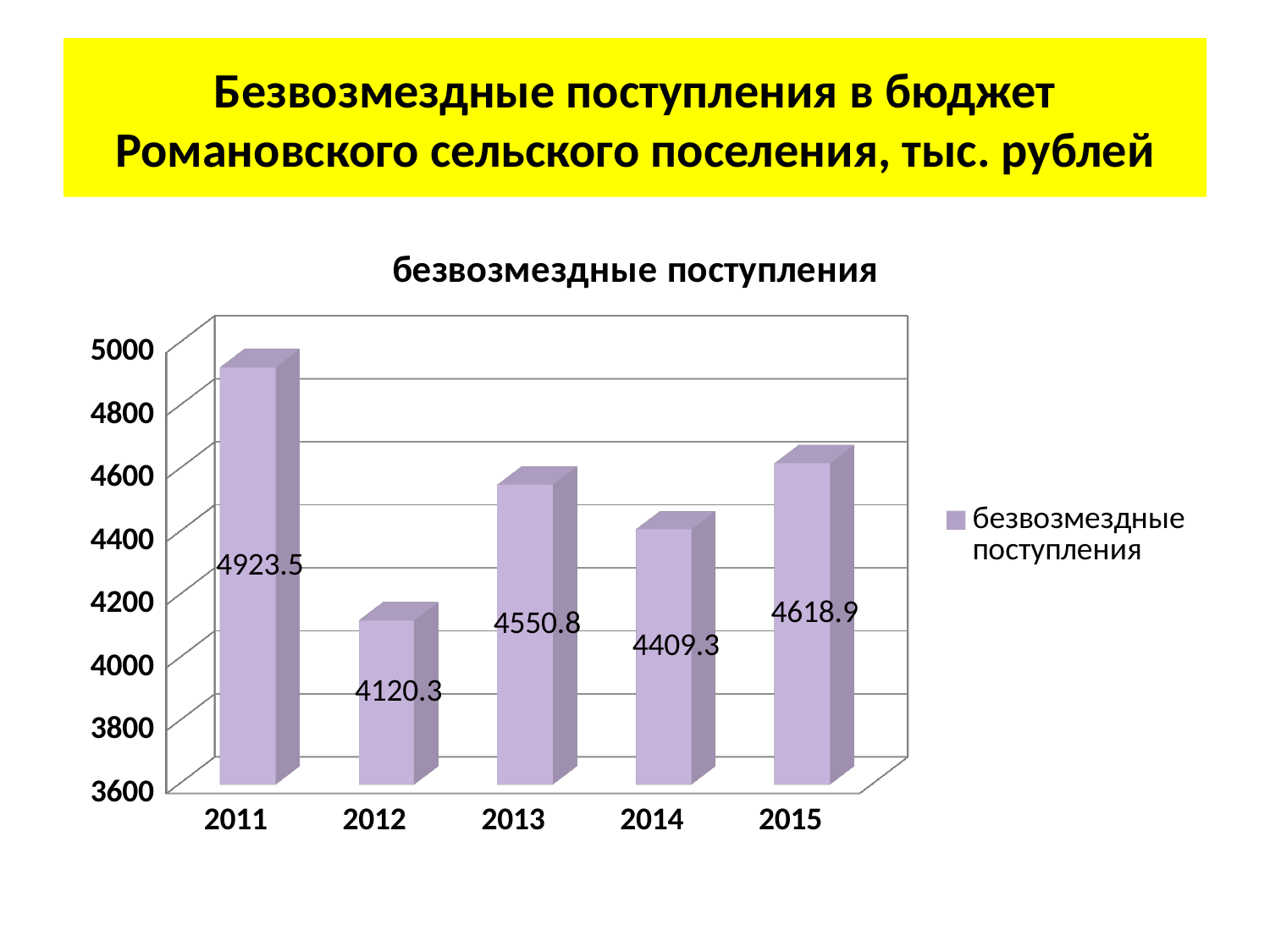
What is the value for 2011? 4923.5 Which year has the lowest value? 2012 What is the value for 2012? 4120.3 Is the value for 2013 greater or less than 4400? greater What is the difference between the values for 2011 and 2012? 803.2 How many years are shown on the x axis? 5 What is the value for 2014? 4409.3 What is the difference between the values for 2015 and 2014? 209.6 What kind of chart is shown? bar chart Which year has the highest value? 2011 What is the title of the chart? безвозмездные поступления Which is larger, the value for 2013 or the value for 2015? 2015